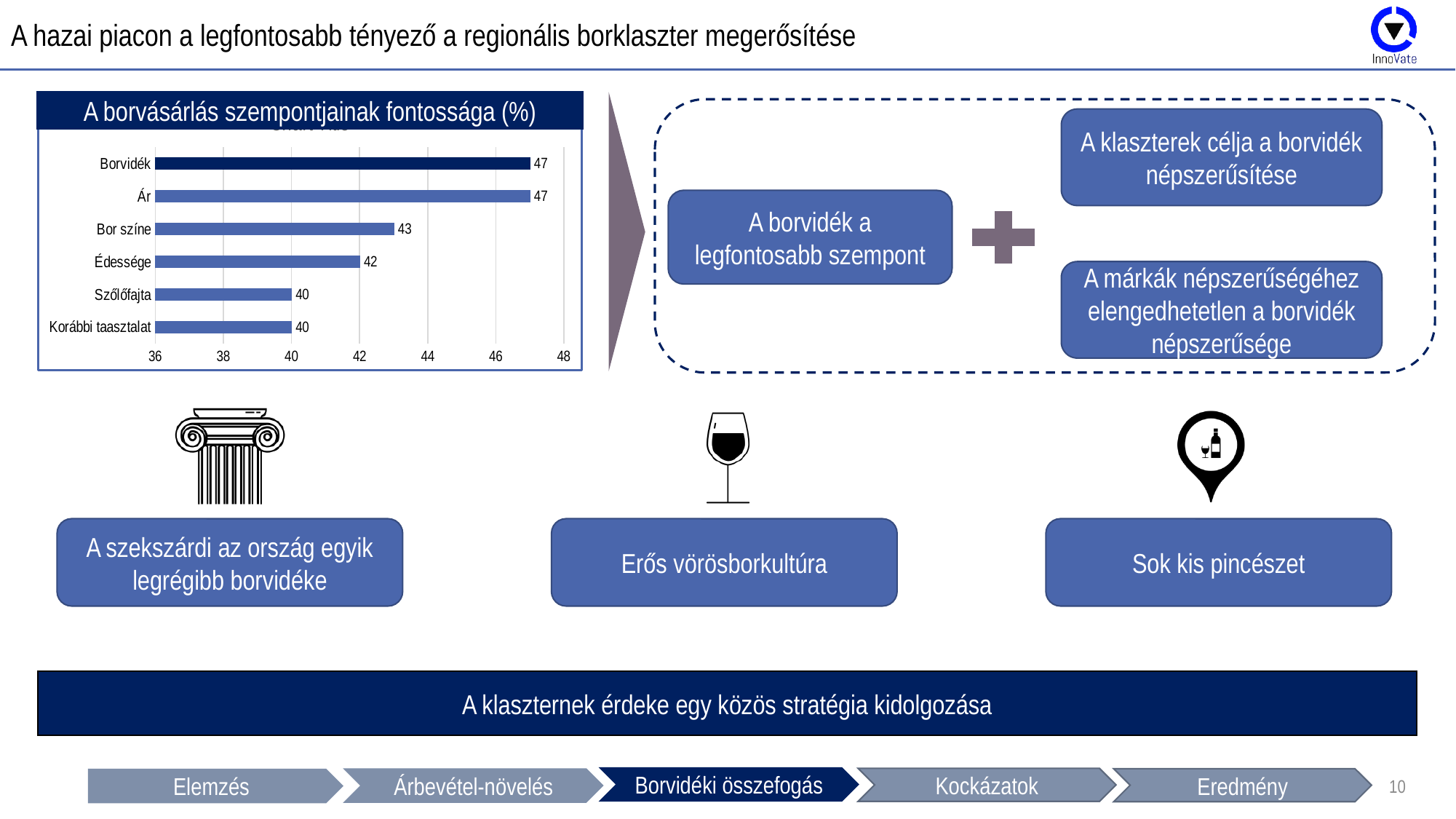
What is the value for Bor színe in the bar chart? 43 What is the value for Szőlőfajta in the bar chart? 40 What is the difference between the values for Ár and Szőlőfajta in the bar chart? 7 What type of chart is shown on the slide? bar chart Is the value for Bor színe in the bar chart greater or less than 42? greater Which is larger in the bar chart: the value for Borvidék or the value for Édessége? Borvidék What is the difference between the values for Bor színe and Korábbi taasztalat in the bar chart? 3 What is the value for Borvidék in the chart 'A borvásárlás szempontjainak fontossága (%)'? 47 What is the title of the chart on the slide? A borvásárlás szempontjainak fontossága (%) What is the value for Édessége in the bar chart? 42 How many categories are shown in the bar chart? 6 What is the value for Ár in the bar chart? 47